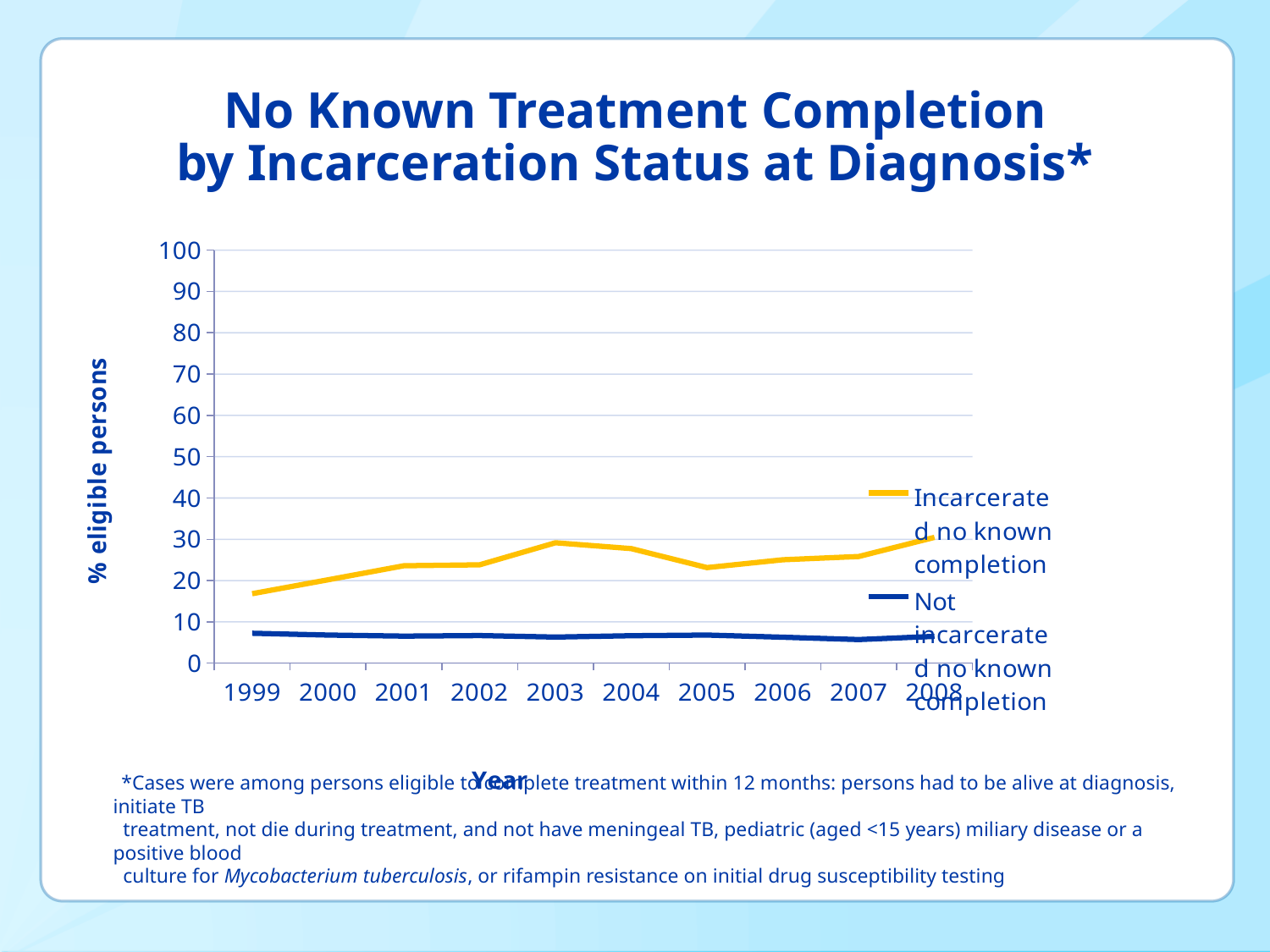
Is the value for Incarcerated no known completion in 2008 greater or less than 40? less How many years are plotted along the x axis? 10 What is the label on the y axis? % eligible persons Is the value for Not incarcerated no known completion in 2005 greater or less than 10? less Is the value for Incarcerated no known completion in 2003 greater or less than 20? greater Does the Incarcerated no known completion series generally rise or fall from 1999 to 2008? rise Which series has the higher value in 2003, Incarcerated no known completion or Not incarcerated no known completion? Incarcerated no known completion In which year is the Incarcerated no known completion series at its lowest? 1999 How many series does the legend list? 2 Which colour is used for the Not incarcerated no known completion series? Blue What kind of chart is shown on the slide? Line chart